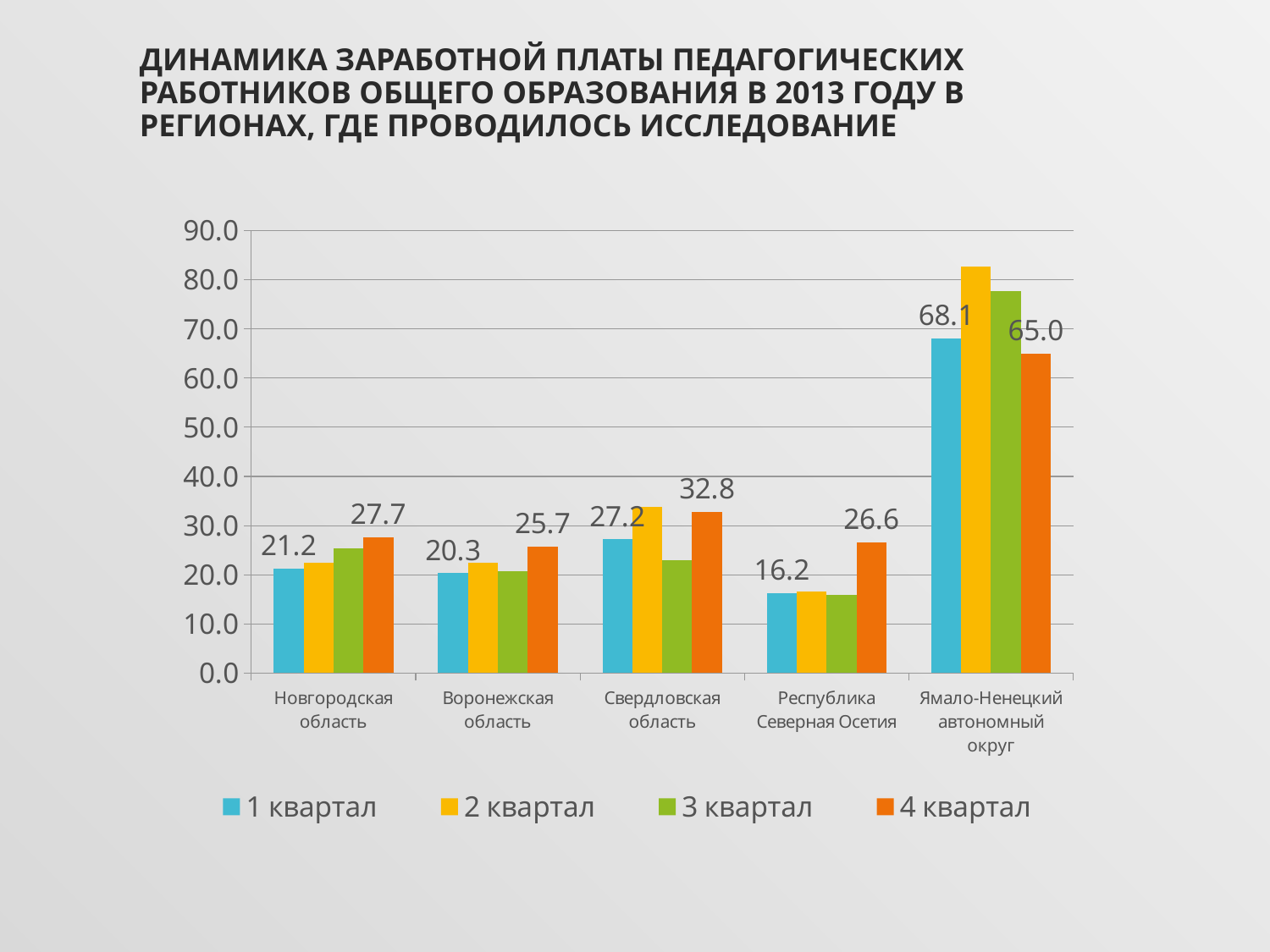
What is the value for 1 квартал in Ямало-Ненецкий автономный округ? 68.1 What is the value for 4 квартал in Республика Северная Осетия? 26.6 What is the difference between the 4 квартал and 1 квартал values for Воронежская область? 5.4 What is the value for 1 квартал in Новгородская область? 21.2 What is the value for 4 квартал in Свердловская область? 32.8 How many regions are shown on the x axis? 5 Which region has the highest value for 1 квартал? Ямало-Ненецкий автономный округ What type of chart is shown on the slide? bar chart Which is larger for Ямало-Ненецкий автономный округ: the 1 квартал value or the 4 квартал value? 1 квартал How many series does the legend list? 4 Which region has the lowest value for 1 квартал? Республика Северная Осетия Is the value for 2 квартал in Ямало-Ненецкий автономный округ greater or less than 80.0? greater